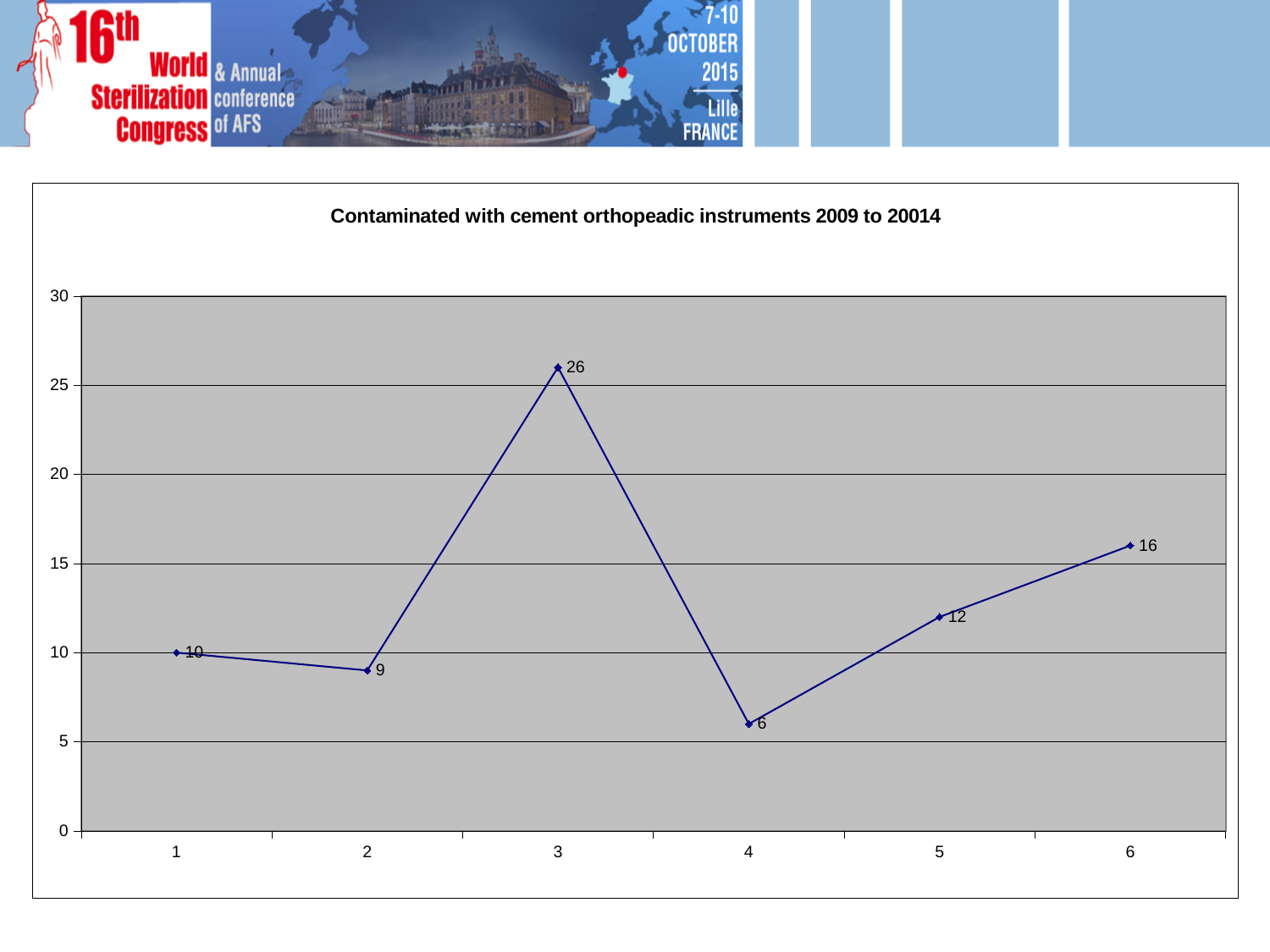
What kind of chart is shown on the slide? line chart What is the difference between the values at point 3 and point 4? 20 What is the value at point 3? 26 How many points are plotted on the chart? 6 What is the value at point 1? 10 Which is larger, the value at point 1 or the value at point 2? point 1 Is the value at point 5 greater or less than 10? greater What is the value at point 6? 16 What is the difference between the values at point 6 and point 5? 4 What is the title of the chart? Contaminated with cement orthopeadic instruments 2009 to 20014 Which point has the highest value? 3 Which point has the lowest value? 4